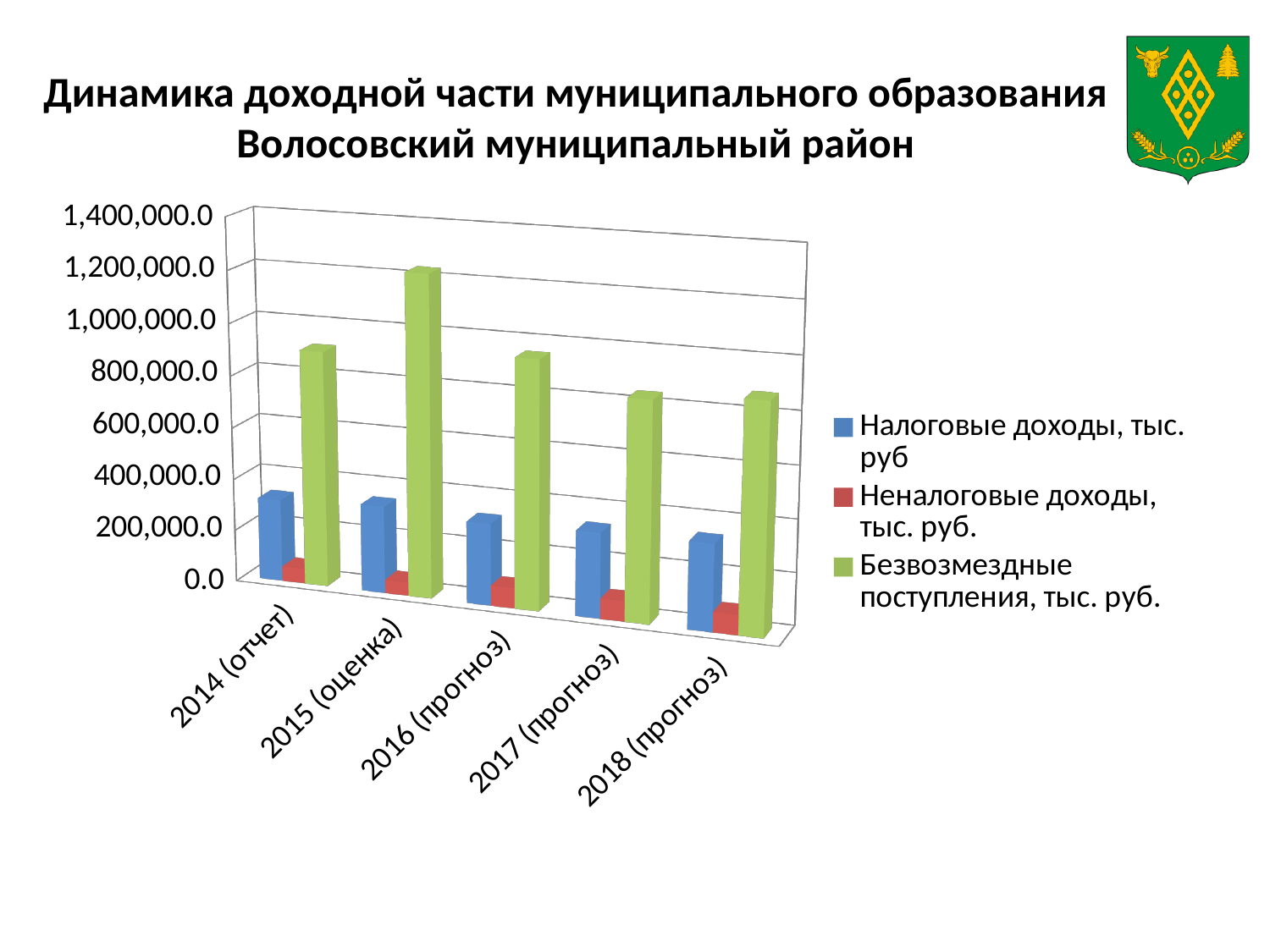
What kind of chart is shown on the slide? bar chart How many year categories are shown on the x axis of the chart? 5 How many series does the chart legend list? 3 Which is larger in 2014 (отчет): Налоговые доходы or Безвозмездные поступления? Безвозмездные поступления Is the value for Налоговые доходы in 2014 (отчет) greater or less than 400,000.0? less Which is larger for Безвозмездные поступления: 2015 (оценка) or 2017 (прогноз)? 2015 (оценка) Is the value for Безвозмездные поступления in 2014 (отчет) greater or less than 800,000.0? greater Is the value for Безвозмездные поступления in 2017 (прогноз) greater or less than 600,000.0? greater Which series is shown in green in the chart? Безвозмездные поступления, тыс. руб. In which year is the value for Безвозмездные поступления, тыс. руб. the highest? 2015 (оценка)